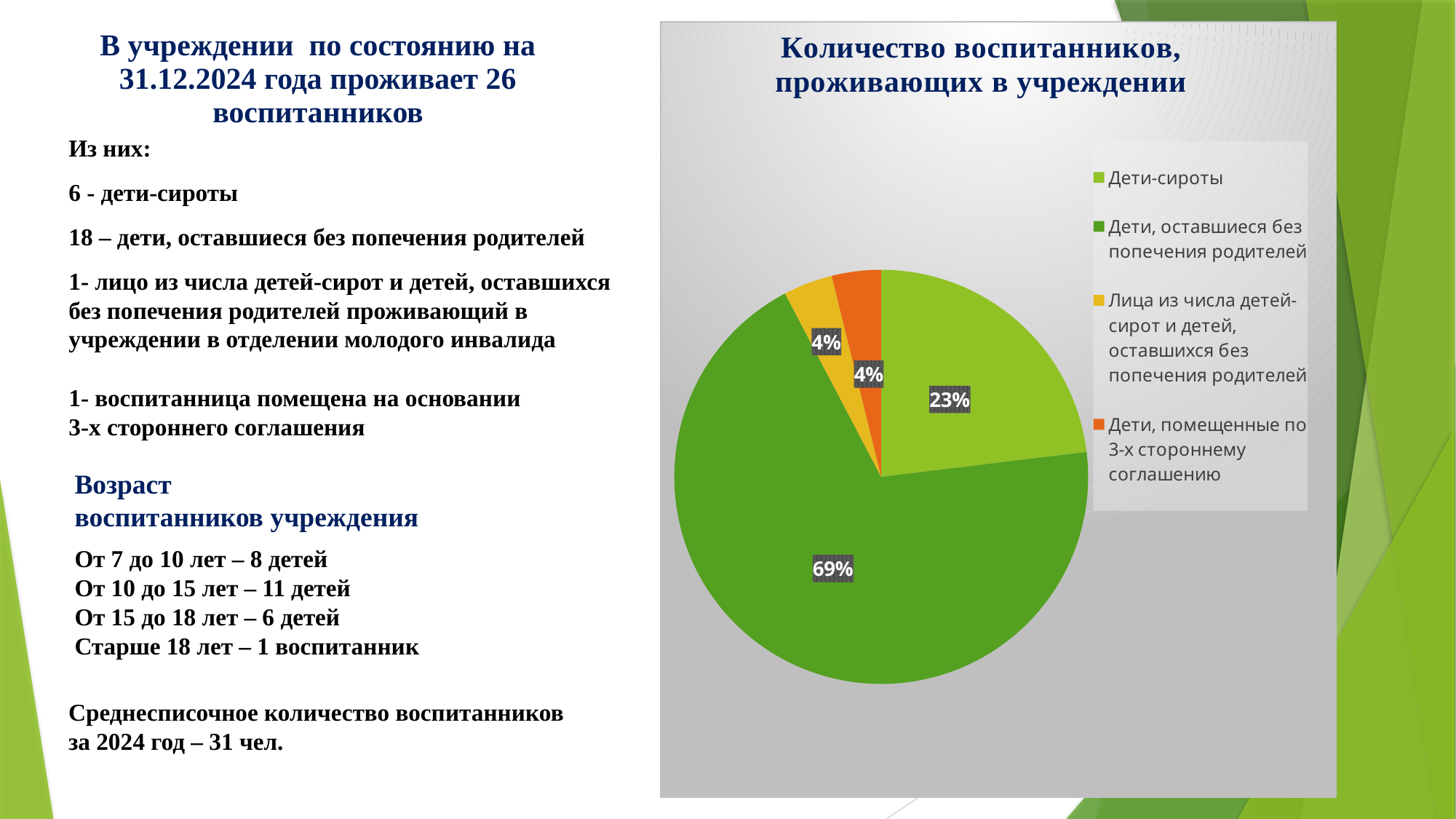
What share of the pie is "Лица из числа детей-сирот и детей, оставшихся без попечения родителей"? 4% What share of the pie is "Дети-сироты"? 23% Which category has the largest slice of the pie? Дети, оставшиеся без попечения родителей What share of the pie is "Дети, оставшиеся без попечения родителей"? 69% How many slices does the pie chart have? 4 Which is larger: the slice for "Дети-сироты" or the slice for "Дети, оставшиеся без попечения родителей"? Дети, оставшиеся без попечения родителей How many entries does the chart legend list? 4 What kind of chart is shown on the slide? pie chart What colour is the slice for "Дети, помещенные по 3-х стороннему соглашению"? orange What is the difference in percentage points between the "Дети, оставшиеся без попечения родителей" slice and the "Дети-сироты" slice? 46% What is the title of the chart? Количество воспитанников, проживающих в учреждении